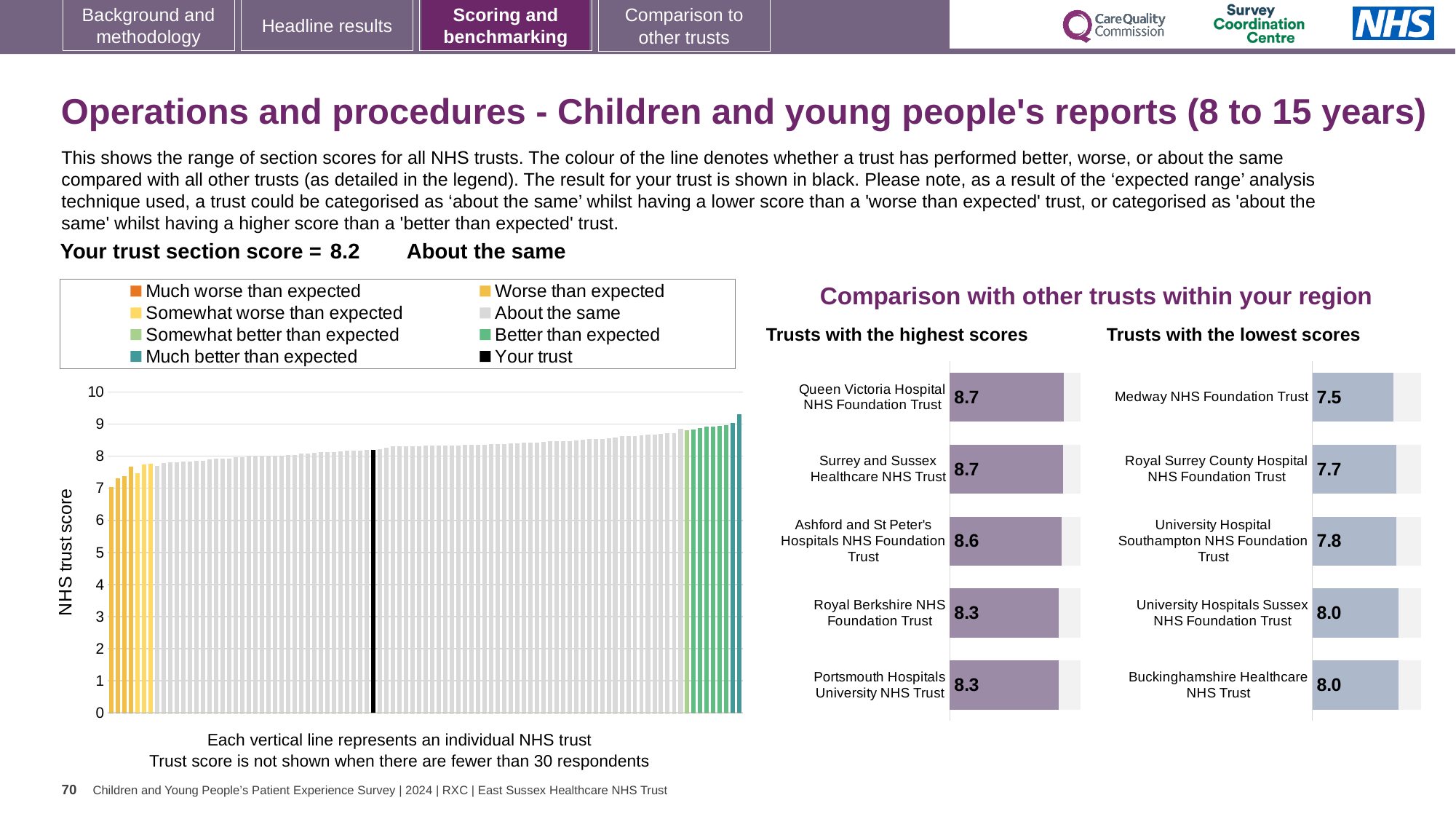
How many entries does the legend of the 'NHS trust score' chart list? 8 In the 'Trusts with the highest scores' chart, what is the score for Ashford and St Peter's Hospitals NHS Foundation Trust? 8.6 In the 'NHS trust score' chart, is the value of the leftmost bar greater or less than 8? less In the 'NHS trust score' chart, what is the section score for your trust (shown in black)? 8.2 In the 'Trusts with the lowest scores' chart, which trust has the lowest score? Medway NHS Foundation Trust In the 'NHS trust score' chart, do the bars rise or fall from left to right? rise What kind of chart is the 'NHS trust score' chart on the left of the slide? bar chart In the 'Trusts with the lowest scores' chart, what is the score for University Hospital Southampton NHS Foundation Trust? 7.8 How many trusts are shown in the 'Trusts with the highest scores' chart? 5 In the 'Trusts with the lowest scores' chart, what is the difference between the scores of Buckinghamshire Healthcare NHS Trust and Medway NHS Foundation Trust? 0.5 In the 'Trusts with the highest scores' chart, what is the difference between the scores of Queen Victoria Hospital NHS Foundation Trust and Portsmouth Hospitals University NHS Trust? 0.4 In the 'Trusts with the lowest scores' chart, which has the higher score: Medway NHS Foundation Trust or Royal Surrey County Hospital NHS Foundation Trust? Royal Surrey County Hospital NHS Foundation Trust